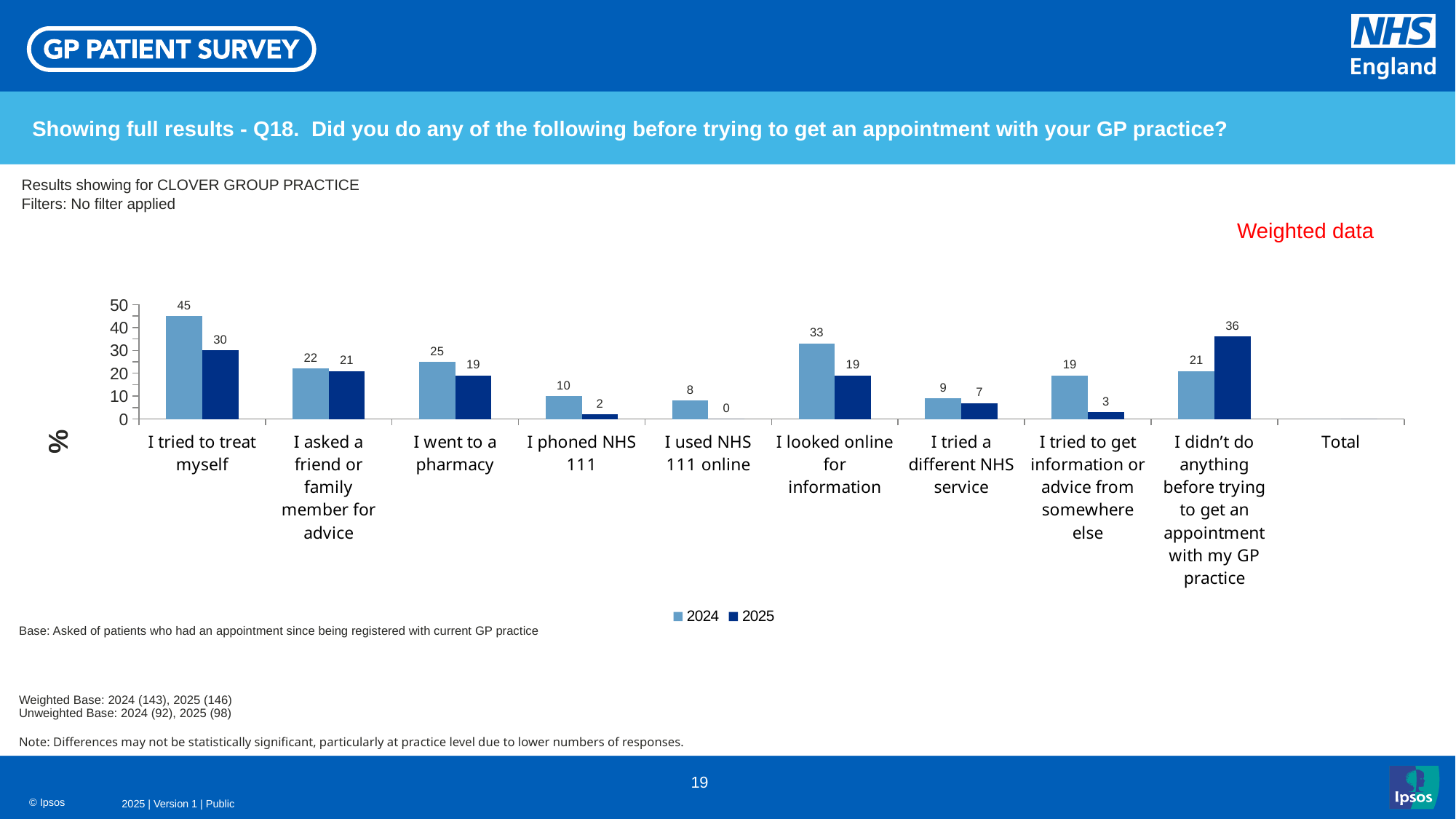
What is the difference between the 2024 and 2025 values for "I looked online for information"? 14 What are the two series listed in the legend? 2024 and 2025 Which category has the highest 2024 value? I tried to treat myself What kind of chart is shown on the slide? Bar chart Is the 2024 value for "I went to a pharmacy" greater or less than 20? greater What is the 2024 value for "I tried to treat myself"? 45 How many series does the legend list? 2 What is the 2025 value for "I used NHS 111 online"? 0 What is the 2025 value for "I didn't do anything before trying to get an appointment with my GP practice"? 36 What is the 2025 value for "I tried to get information or advice from somewhere else"? 3 Which is larger for "I didn't do anything before trying to get an appointment with my GP practice": the 2024 value or the 2025 value? 2025 Which category has the lowest 2025 value? I used NHS 111 online